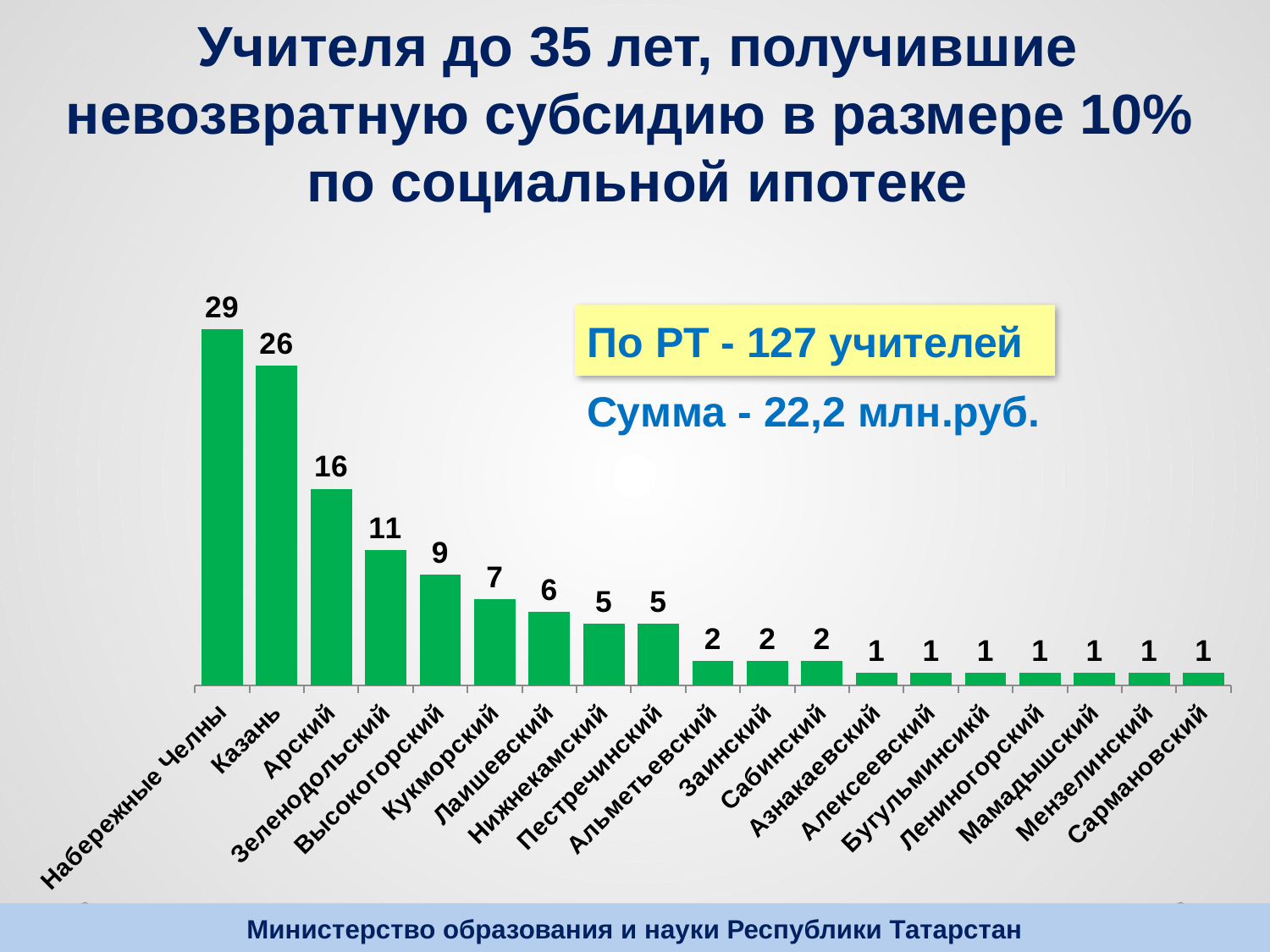
Which category has the highest value? Набережные Челны Which is larger, the value for Лаишевский or the value for Нижнекамский? Лаишевский What value is shown for Зеленодольский? 11 What kind of chart is shown on the slide? bar chart How many categories are shown on the x axis? 19 According to the text box on the slide, how many teachers are there in total for RT (По РТ)? 127 учителей What value is shown for Кукморский? 7 What value is shown for Арский? 16 Do the values rise or fall from left to right along the x axis? fall What is the difference between the values for Арский and Высокогорский? 7 What value is shown for Казань? 26 What is the difference between the values for Набережные Челны and Казань? 3